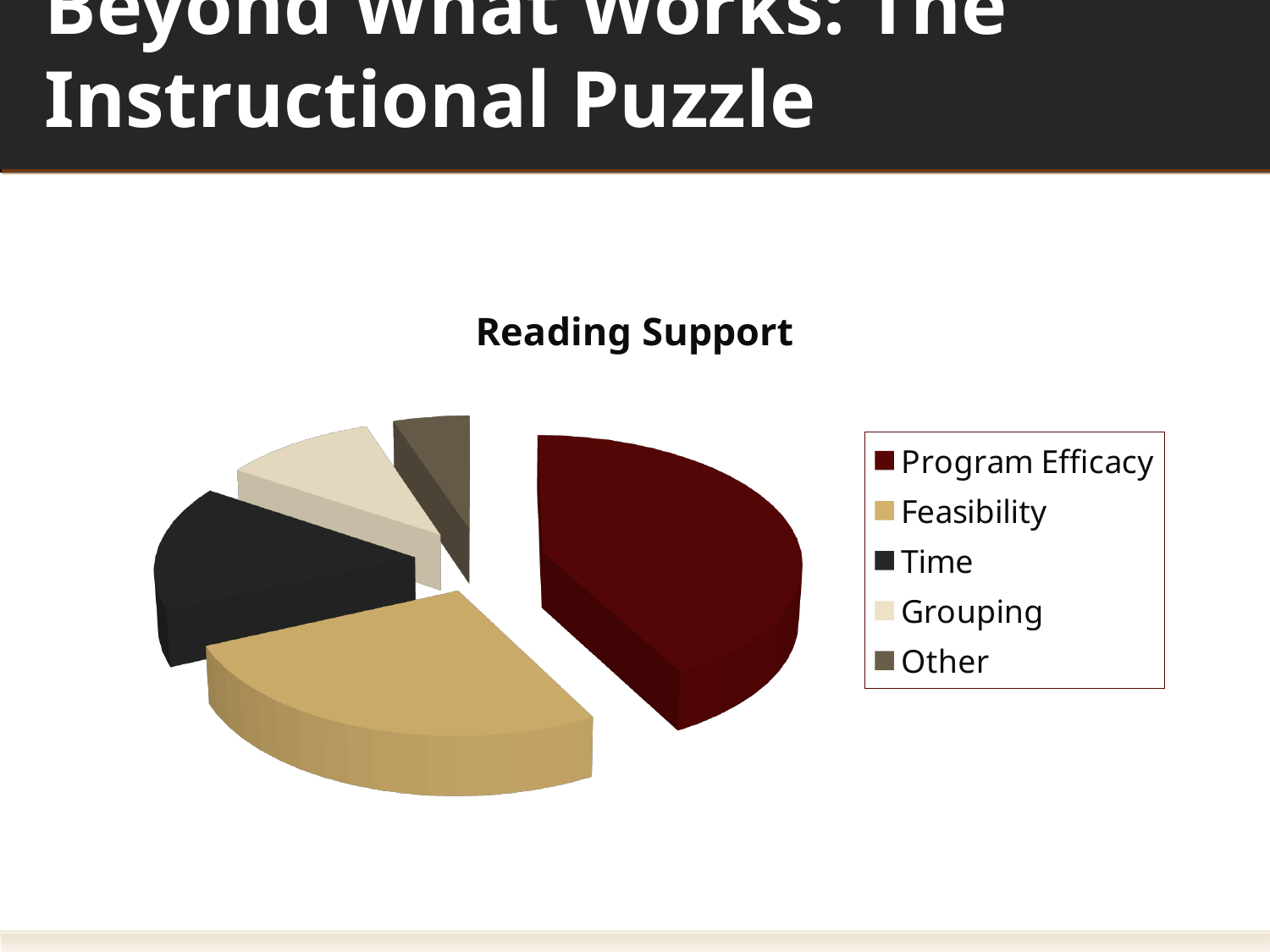
What is the title of the chart? Reading Support What kind of chart is shown on the slide? Pie chart Which slice is larger, Feasibility or Time? Feasibility Which slice is larger, Time or Grouping? Time Which category has the smallest slice of the pie? Other Which slice is larger, Program Efficacy or Other? Program Efficacy Which category is shown in dark red in the legend? Program Efficacy How many entries does the legend list? 5 How many slices does the pie chart have? 5